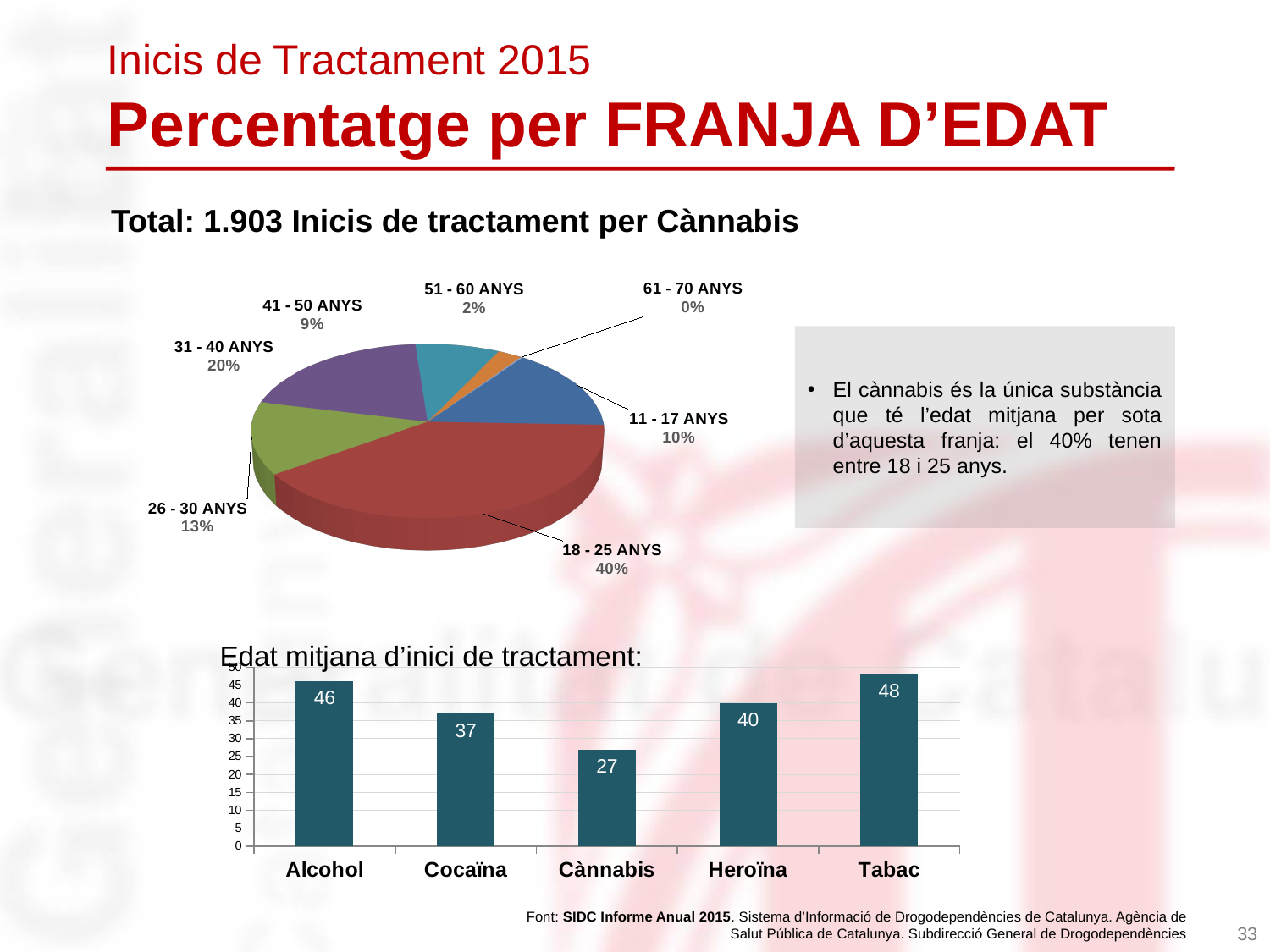
In the bar chart 'Edat mitjana d'inici de tractament', which substance has the lowest mean age of treatment start? Cànnabis In the bar chart 'Edat mitjana d'inici de tractament', what is the difference between the values for Alcohol and Cocaïna? 9 What kind of chart is the lower chart 'Edat mitjana d'inici de tractament'? Bar chart In the pie chart, what is the difference in percentage points between 31 - 40 ANYS and 26 - 30 ANYS? 7 In the pie chart, which age group has the smallest share? 61 - 70 ANYS In the pie chart, what percentage of cannabis treatment starts are in the 18 - 25 ANYS age group? 40% In the pie chart, what percentage corresponds to 31 - 40 ANYS? 20% In the pie chart, which age group has the largest share? 18 - 25 ANYS In the pie chart, how many age groups are shown? 7 In the bar chart 'Edat mitjana d'inici de tractament', which substance has the highest mean age of treatment start? Tabac In the bar chart 'Edat mitjana d'inici de tractament', what is the value for Cànnabis? 27 In the bar chart 'Edat mitjana d'inici de tractament', which is larger, the value for Heroïna or the value for Cocaïna? Heroïna